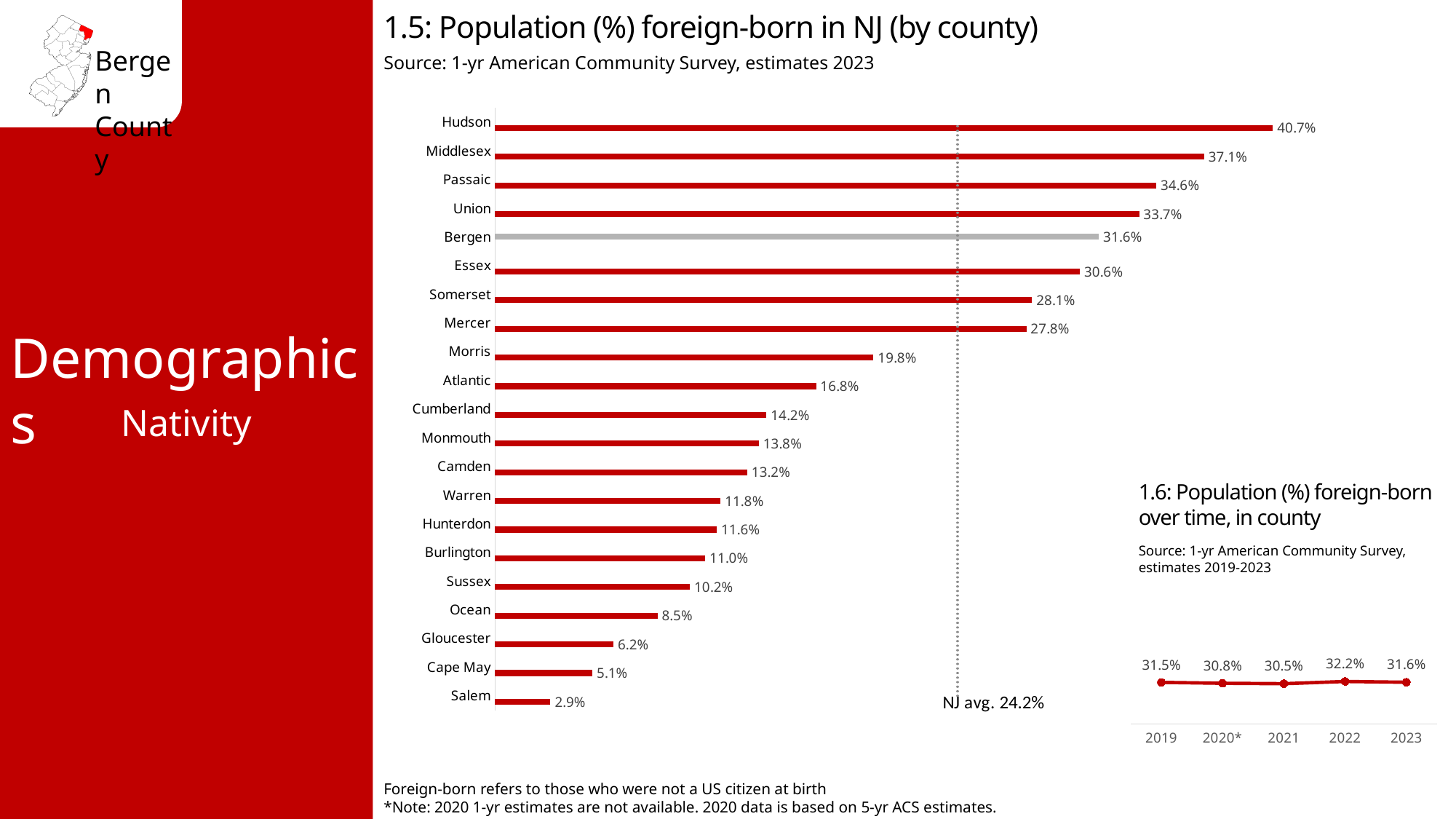
In chart 1.6 (Population (%) foreign-born over time, in county), which year has the lowest value? 2021 What kind of chart is chart 1.5 (Population (%) foreign-born in NJ by county)? Bar chart In chart 1.6 (Population (%) foreign-born over time, in county), what is the value for 2022? 32.2% In chart 1.5 (Population (%) foreign-born in NJ by county), what NJ average is marked by the dotted line? 24.2% In chart 1.5 (Population (%) foreign-born in NJ by county), how many counties are shown? 21 In chart 1.5 (Population (%) foreign-born in NJ by county), what is the difference between Hudson and Middlesex? 3.6% In chart 1.6 (Population (%) foreign-born over time, in county), how many data points are plotted? 5 In chart 1.5 (Population (%) foreign-born in NJ by county), what is the value for Bergen? 31.6% In chart 1.5 (Population (%) foreign-born in NJ by county), which is larger, Passaic or Union? Passaic In chart 1.5 (Population (%) foreign-born in NJ by county), which county has the highest value? Hudson In chart 1.5 (Population (%) foreign-born in NJ by county), what is the value for Morris? 19.8% In chart 1.5 (Population (%) foreign-born in NJ by county), which county has the lowest value? Salem